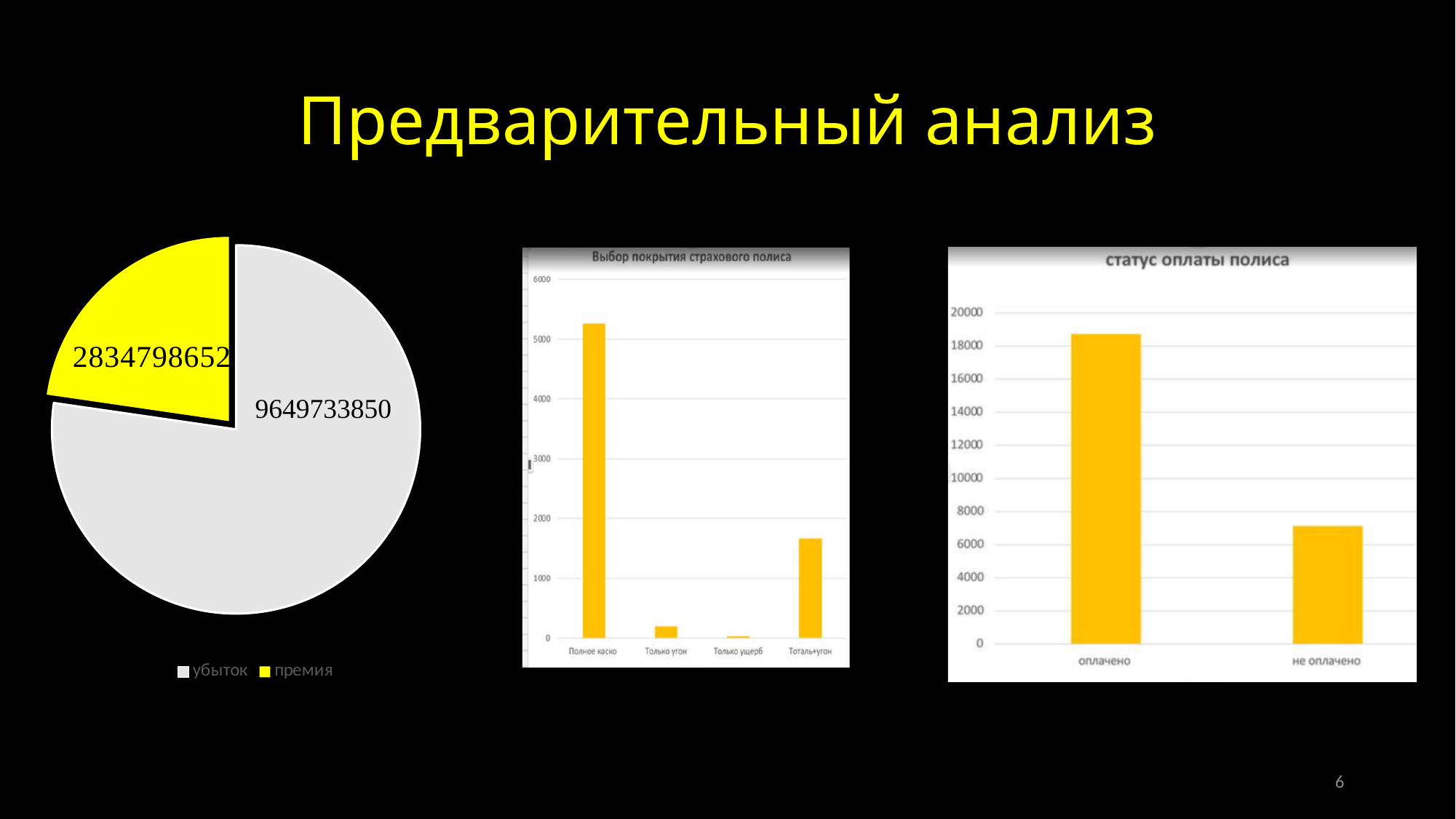
In the pie chart on the left, what is the value of the премия slice? 2834798652 In the chart titled 'Выбор покрытия страхового полиса', how many categories are shown on the x axis? 4 In the chart titled 'Выбор покрытия страхового полиса', is the value for Полное каско greater or less than 5000? greater In the pie chart on the left, what is the total of the two slices? 12484532502 In the pie chart on the left, what is the difference between the убыток value and the премия value? 6814935198 In the chart titled 'статус оплаты полиса', is the value for оплачено greater or less than 18000? greater In the pie chart on the left, which slice is larger, убыток or премия? убыток In the chart titled 'Выбор покрытия страхового полиса', which category has the lowest value? Только ущерб In the pie chart on the left, what is the value of the убыток slice? 9649733850 In the pie chart on the left, how many entries does the legend list? 2 In the chart titled 'Выбор покрытия страхового полиса', which category has the highest value? Полное каско What kind of chart is the chart titled 'статус оплаты полиса'? bar chart